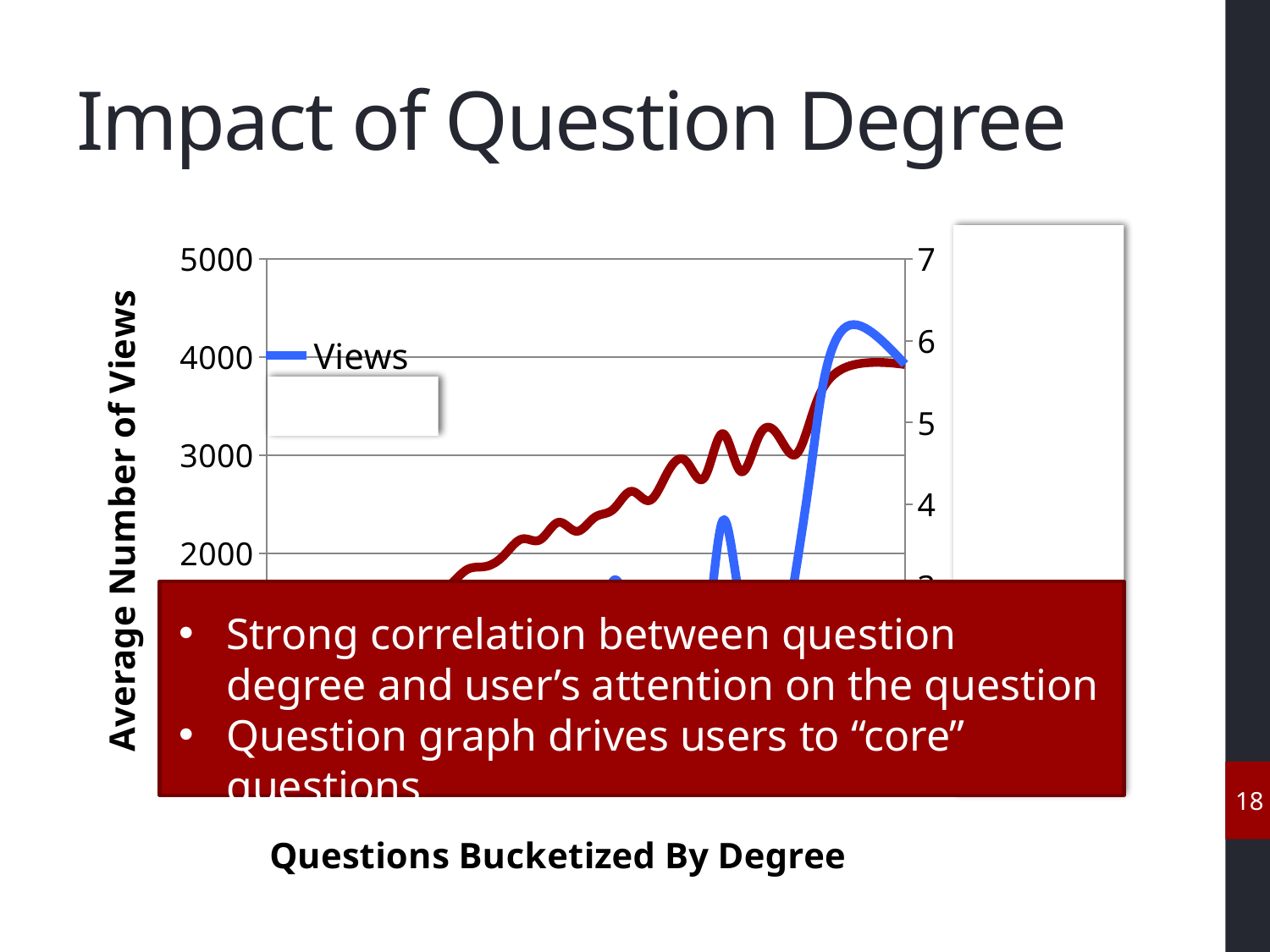
What is the title of the horizontal axis? Questions Bucketized By Degree Do the values of the Views series generally rise or fall from left to right along the x axis? rise What is the title of the left vertical axis? Average Number of Views Which series name is readable in the chart legend? Views Is the highest point of the Views line greater or less than 4000 on the left axis? greater How many lines are plotted on the chart? 2 What kind of chart is shown on the slide? line chart Is the highest point of the Views line greater or less than 5000 on the left axis? less Does the red line generally rise or fall from left to right along the x axis? rise